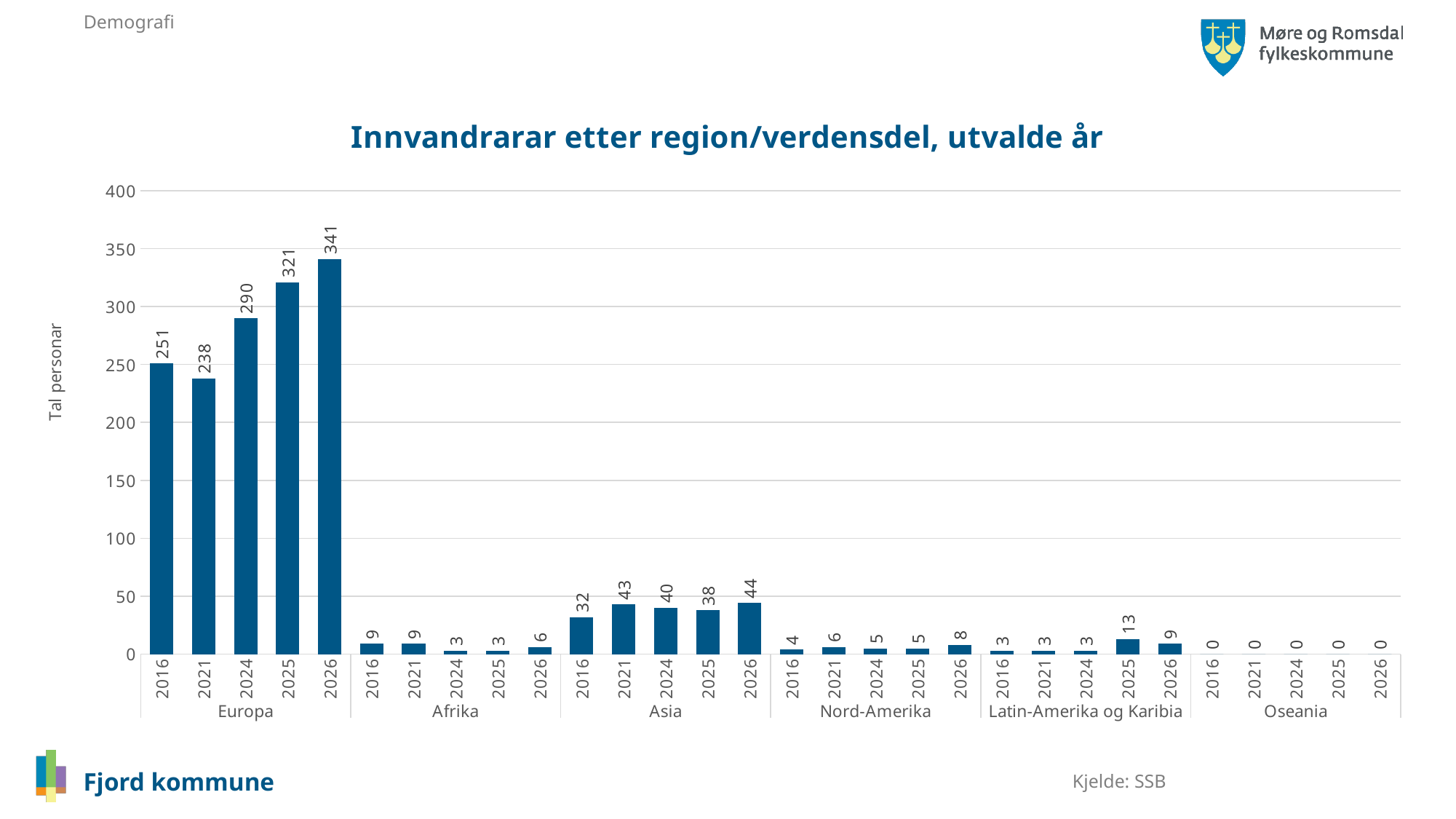
What kind of chart is this? bar chart Which region has the highest value in 2026? Europa What is the value for Latin-Amerika og Karibia in 2025? 13 How many regions are shown on the x axis? 6 Which is larger: Afrika in 2016 or Nord-Amerika in 2016? Afrika in 2016 What is the value for Asia in 2021? 43 Is the value for Europa in 2024 greater or less than 300? less Which year has the lowest value for Europa? 2021 What is the y-axis label of the chart? Tal personar What is the value for Oseania in 2024? 0 What is the difference between the Europa values for 2026 and 2016? 90 What is the value for Europa in 2026? 341